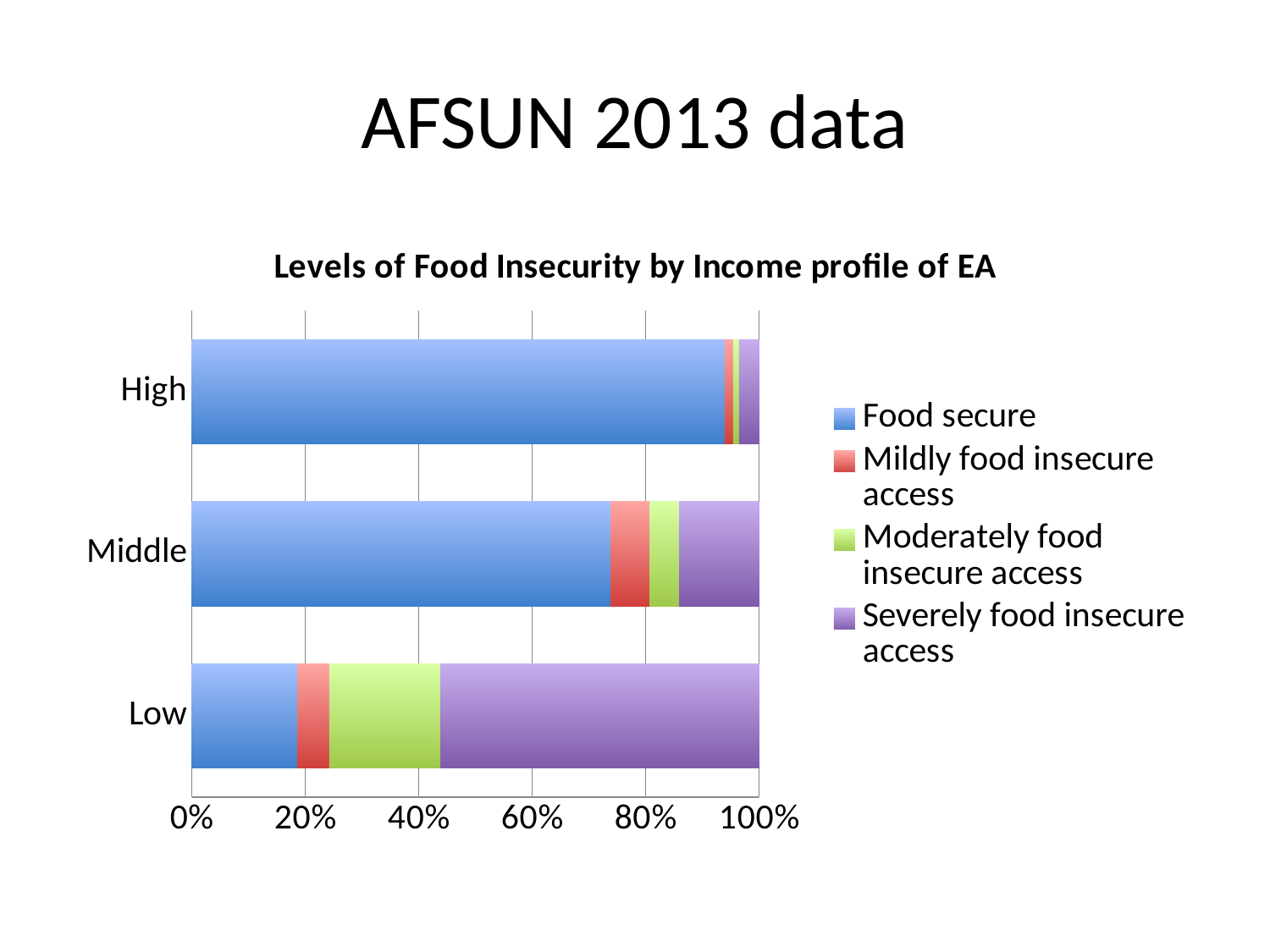
How many income categories are shown on the chart? 3 Is the Food secure share for High greater or less than 80%? greater Which series is shown in purple in the legend? Severely food insecure access Which income category has the smallest Food secure share? Low Which income category has the largest Food secure share? High What kind of chart is shown on the slide? bar chart Is the Food secure share for Low greater or less than 20%? less Which has a larger Severely food insecure access share, Low or Middle? Low What is the title of the chart? Levels of Food Insecurity by Income profile of EA Is the Severely food insecure access share for Low greater or less than 40%? greater How many series does the legend list? 4